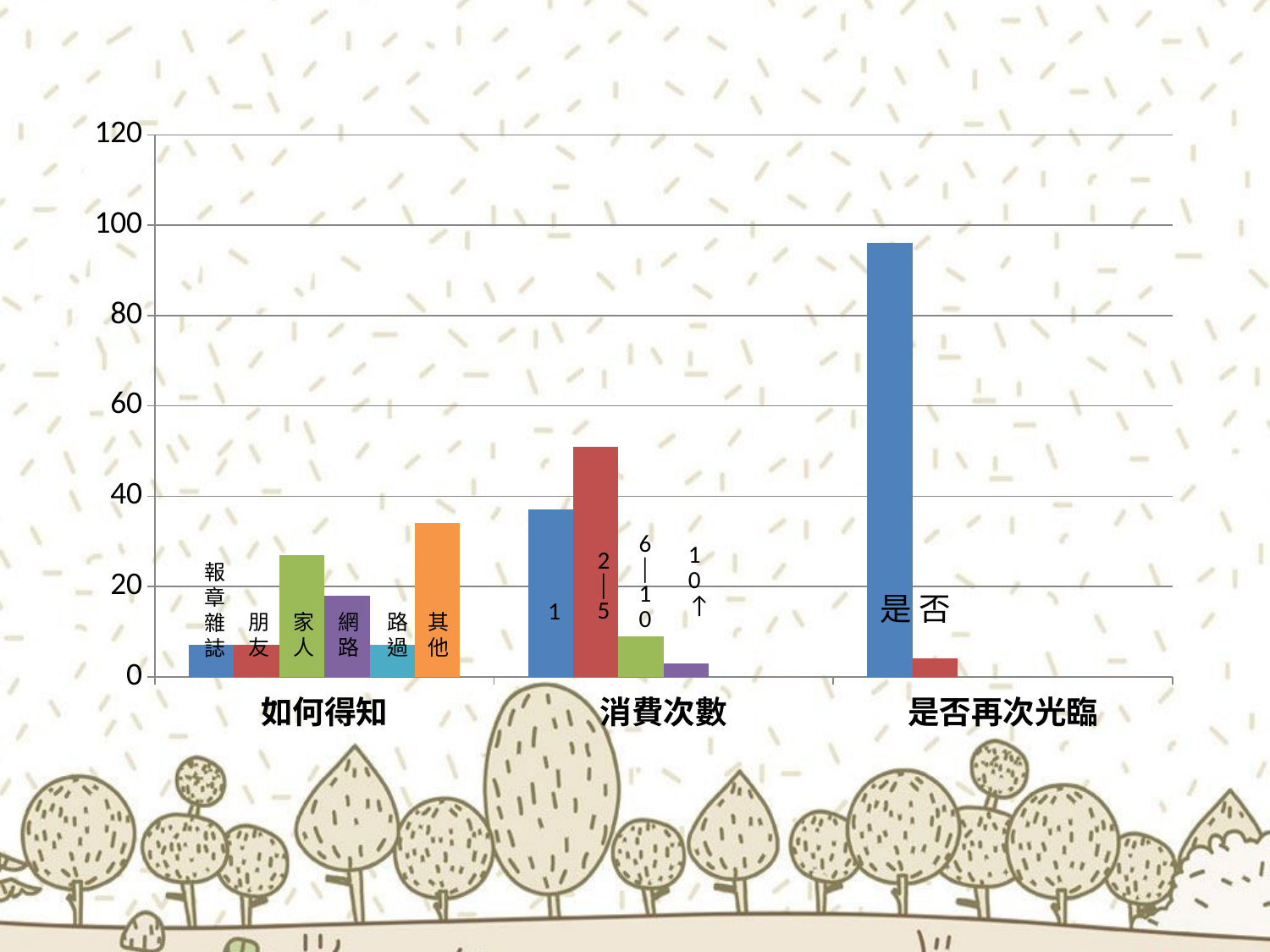
Which bar is the tallest in the whole chart? 是 (in 是否再次光臨) Is the value for 其他 in the 如何得知 group greater or less than 40? less Within the 消費次數 group, which bar is the highest? 2—5 How many category groups are shown along the x axis? 3 Within the 消費次數 group, which bar is the lowest? 10↑ Is the value for 是 in the 是否再次光臨 group greater or less than 80? greater What kind of chart is shown on the slide? bar chart Is the value for 否 in the 是否再次光臨 group greater or less than 20? less What is the highest value shown on the vertical axis? 120 Within the 如何得知 group, which bar is the highest? 其他 Which is larger, the bar for 家人 or the bar for 網路? 家人